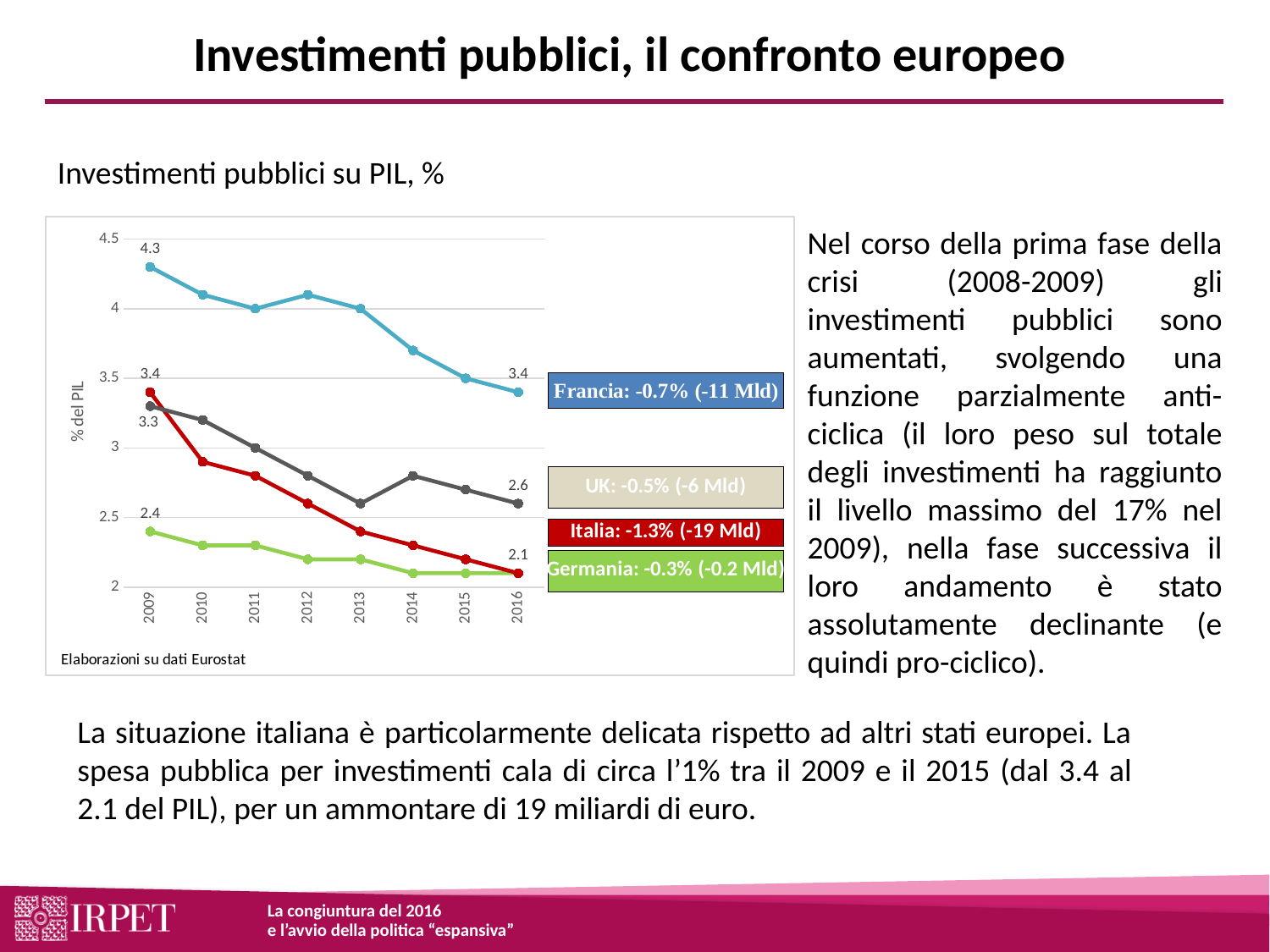
How many years are shown on the x axis of the chart? 8 How many countries (series) are plotted in the chart? 4 What is the value for Francia in 2016? 3.4 What is the value for Francia in 2009? 4.3 Does the Francia line rise or fall from 2009 to 2016? fall What is the value for UK in 2016? 2.6 What kind of chart is shown on the slide? line chart By how much did the value for Francia fall between 2009 and 2016? 0.9 What is the value for UK in 2009? 3.3 What is the value for Germania in 2009? 2.4 Which country has the highest value in 2009? Francia Is the value for Francia in 2013 greater or less than 3.5? greater